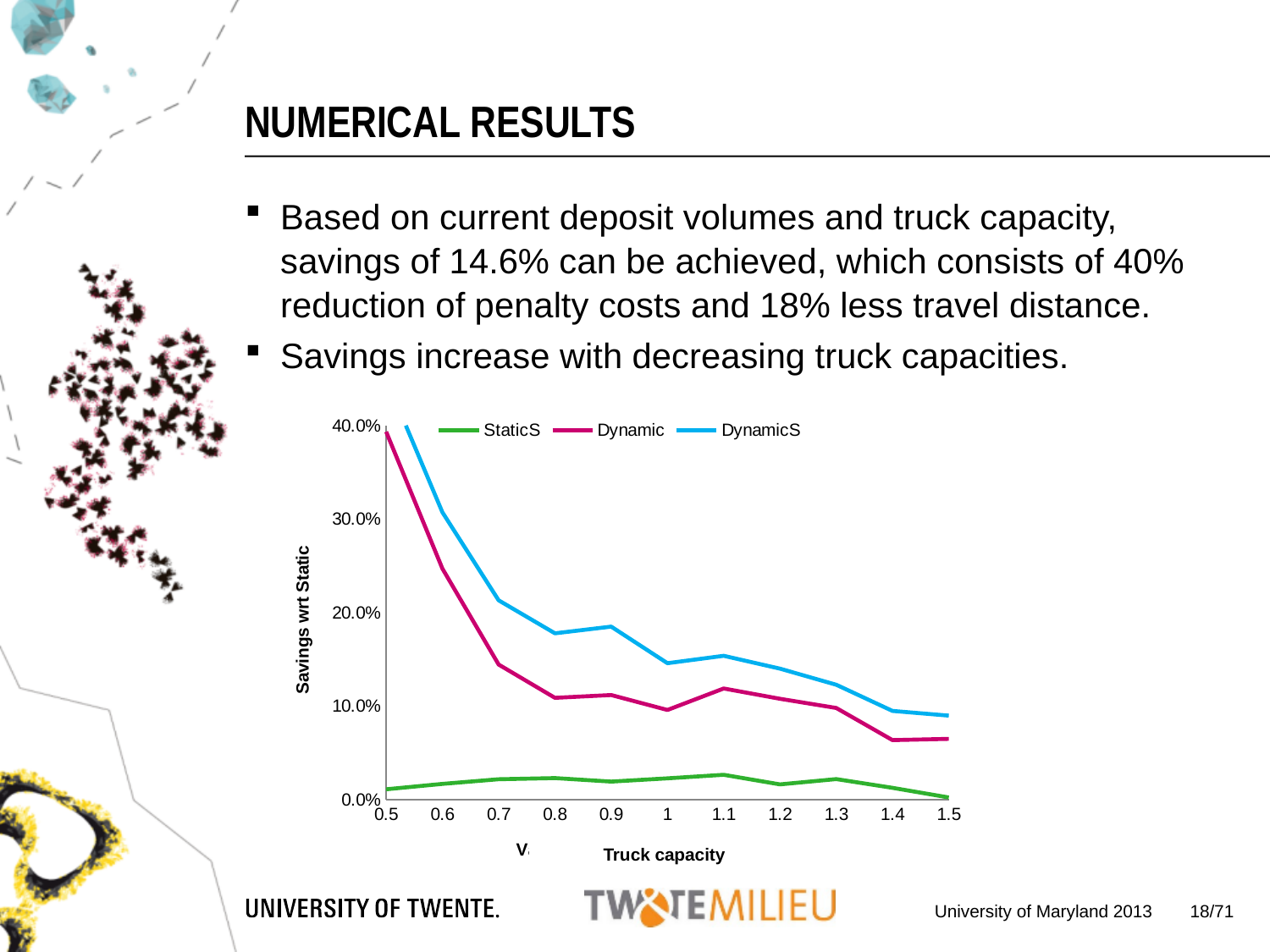
How many series does the chart's legend list? 3 What is the title of the chart's x axis? Truck capacity Which series has the lowest values across the whole range of truck capacities? StaticS What are the three series named in the chart's legend? StaticS, Dynamic, DynamicS What kind of chart is shown on the slide? line chart Does the DynamicS series rise or fall as truck capacity increases from 0.5 to 1.5? fall Is the value for StaticS at truck capacity 1 greater or less than 10.0%? less At truck capacity 0.7, which series has the larger value, Dynamic or DynamicS? DynamicS Is the value for Dynamic at truck capacity 0.5 greater or less than 30.0%? greater Is the value for DynamicS at truck capacity 0.8 greater or less than 20.0%? less How many truck capacity values are plotted along the x axis? 11